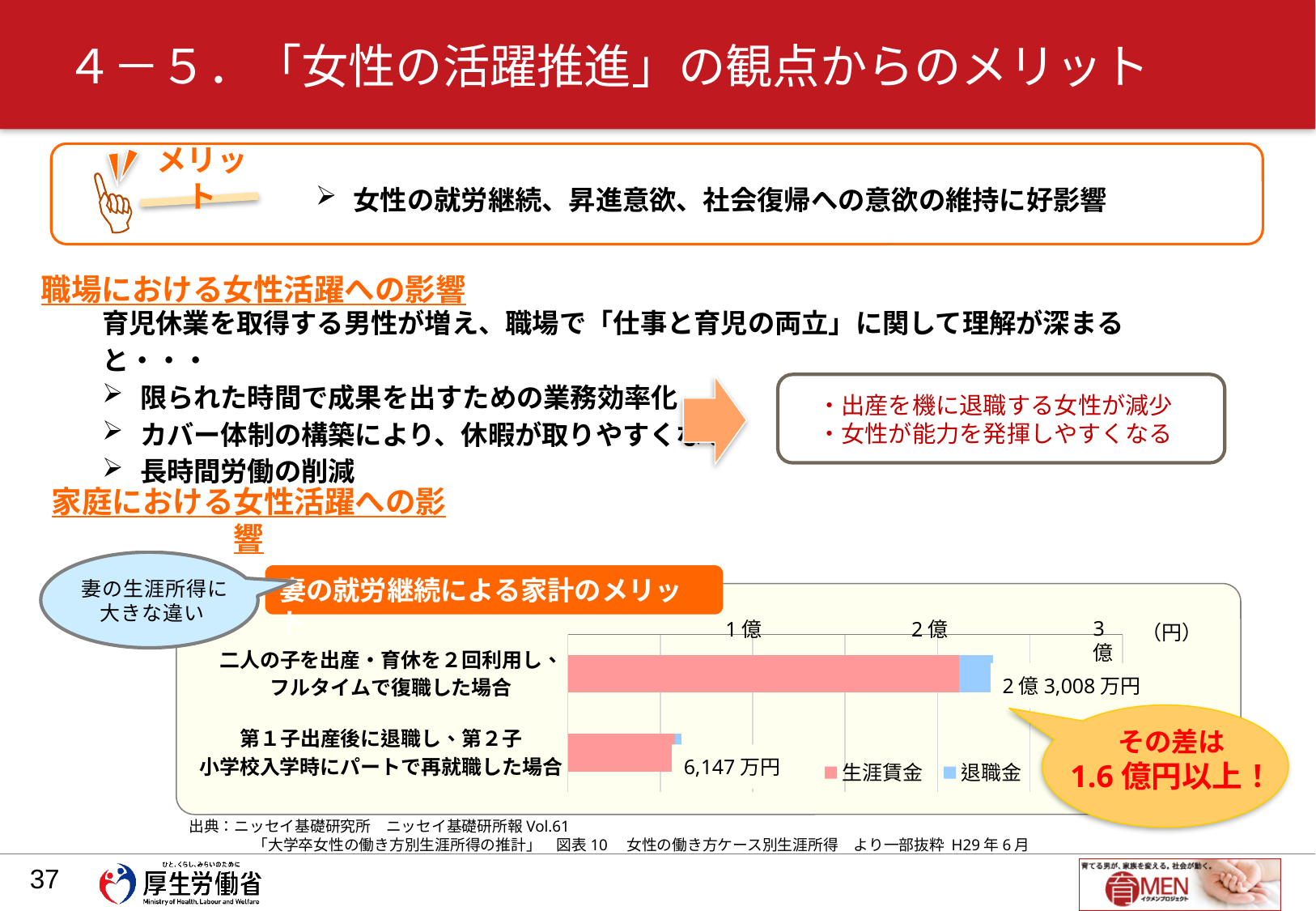
What is the title of the chart? 妻の就労継続による家計のメリット Which case has the higher total lifetime income? 二人の子を出産・育休を２回利用し、フルタイムで復職した場合 How many categories (cases) are plotted in the chart? 2 What kind of chart is shown on the slide? Bar chart Is the total for the full-time return case (二人の子を出産・育休を２回利用し、フルタイムで復職した場合) greater or less than 2億 on the axis? greater What are the two series listed in the chart legend? 生涯賃金, 退職金 What is the difference between the two total lifetime incomes shown in the chart? 1億6,861万円 How many series does the chart legend list? 2 Is the total for the part-time re-employment case (第１子出産後に退職し、第２子小学校入学時にパートで再就職した場合) greater or less than 1億 on the axis? less Which case has the lower total lifetime income? 第１子出産後に退職し、第２子小学校入学時にパートで再就職した場合 What is the total lifetime income shown for the case 第１子出産後に退職し、第２子小学校入学時にパートで再就職した場合? 6,147万円 What is the total lifetime income shown for the case 二人の子を出産・育休を２回利用し、フルタイムで復職した場合? 2億3,008万円